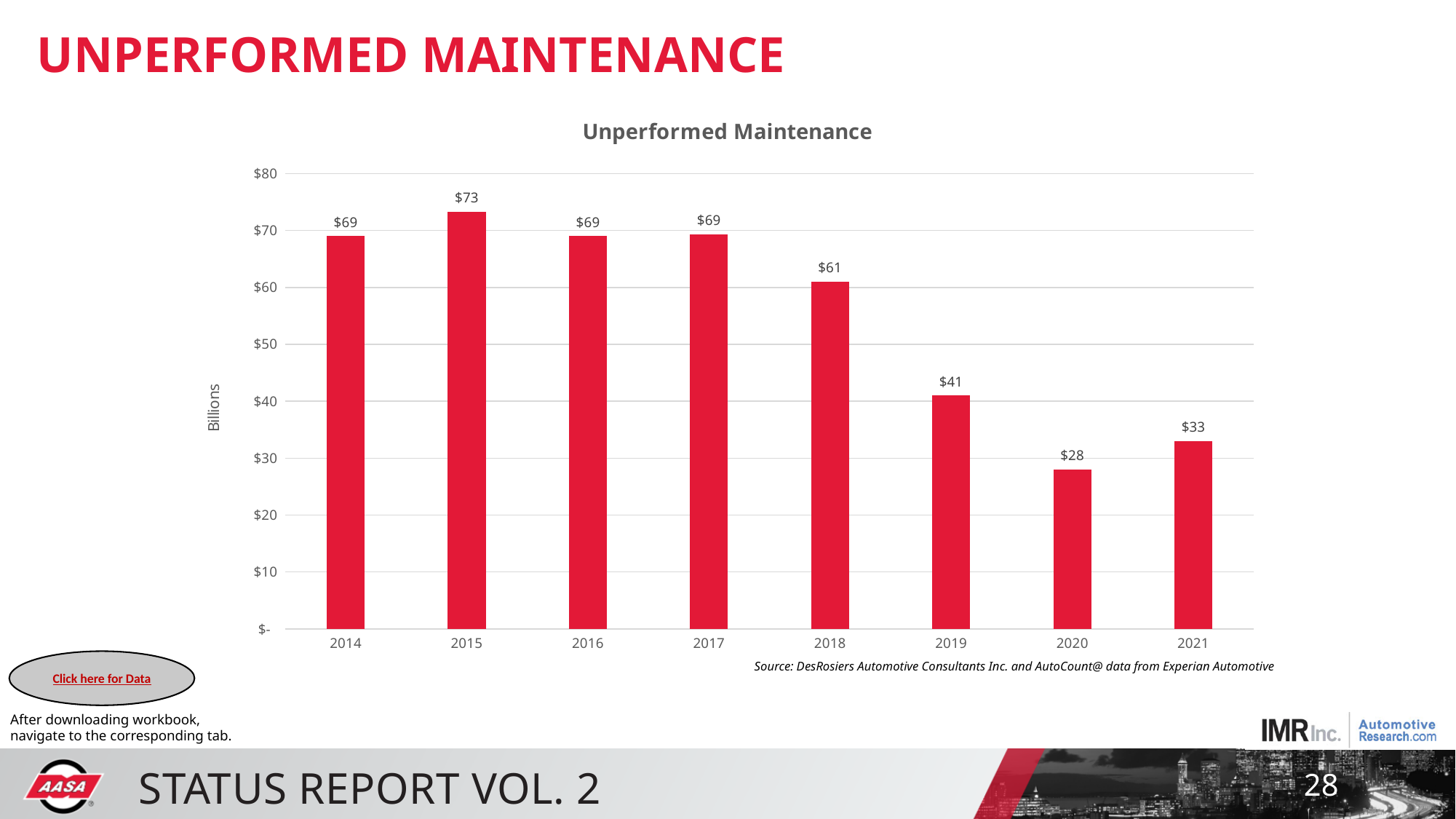
What kind of chart is shown on the slide? Bar chart Do the values generally rise or fall from 2017 to 2020? Fall Which is larger, the value for 2019 or the value for 2021? 2019 What is the label on the vertical axis of the chart? Billions What is the value of unperformed maintenance for 2018? $61 What is the value of unperformed maintenance for 2020? $28 What is the difference between the 2018 value and the 2019 value? $20 Which year has the highest unperformed maintenance value? 2015 What is the value of unperformed maintenance for 2015? $73 What is the difference between the 2015 value and the 2020 value? $45 Which year has the lowest unperformed maintenance value? 2020 How many years are shown on the x axis of the chart? 8